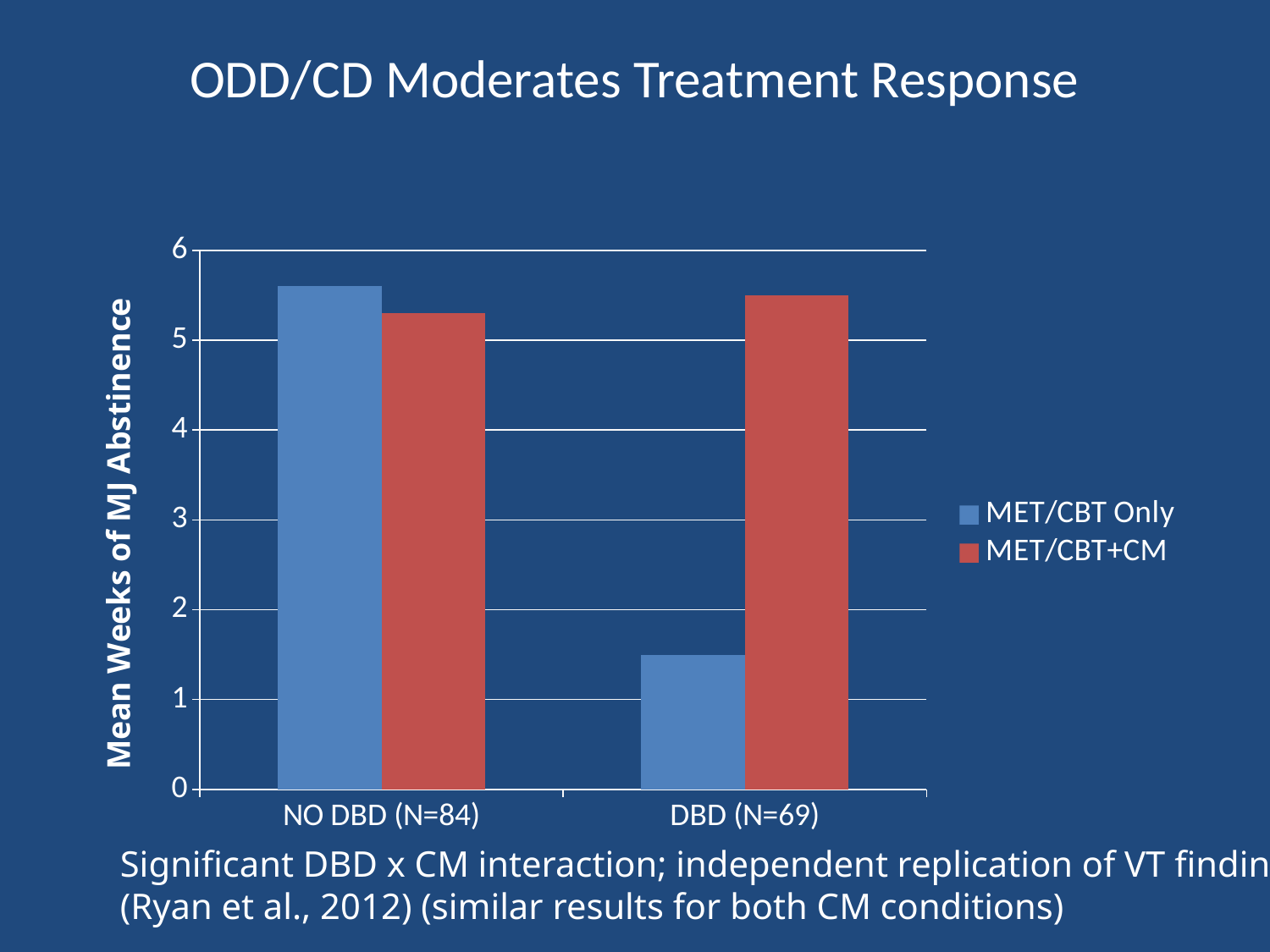
Is the value for MET/CBT+CM in the NO DBD (N=84) group greater or less than 5? greater Which colour represents the MET/CBT+CM series? red For DBD (N=69), which is larger: MET/CBT Only or MET/CBT+CM? MET/CBT+CM Which bar is the lowest in the chart? MET/CBT Only for DBD (N=69) How many categories are shown on the x axis? 2 What kind of chart is shown on the slide? bar chart Is the value for MET/CBT Only in the DBD (N=69) group greater or less than 1? greater What is the label of the y axis? Mean Weeks of MJ Abstinence Is the value for MET/CBT Only in the DBD (N=69) group greater or less than 2? less How many series does the legend list? 2